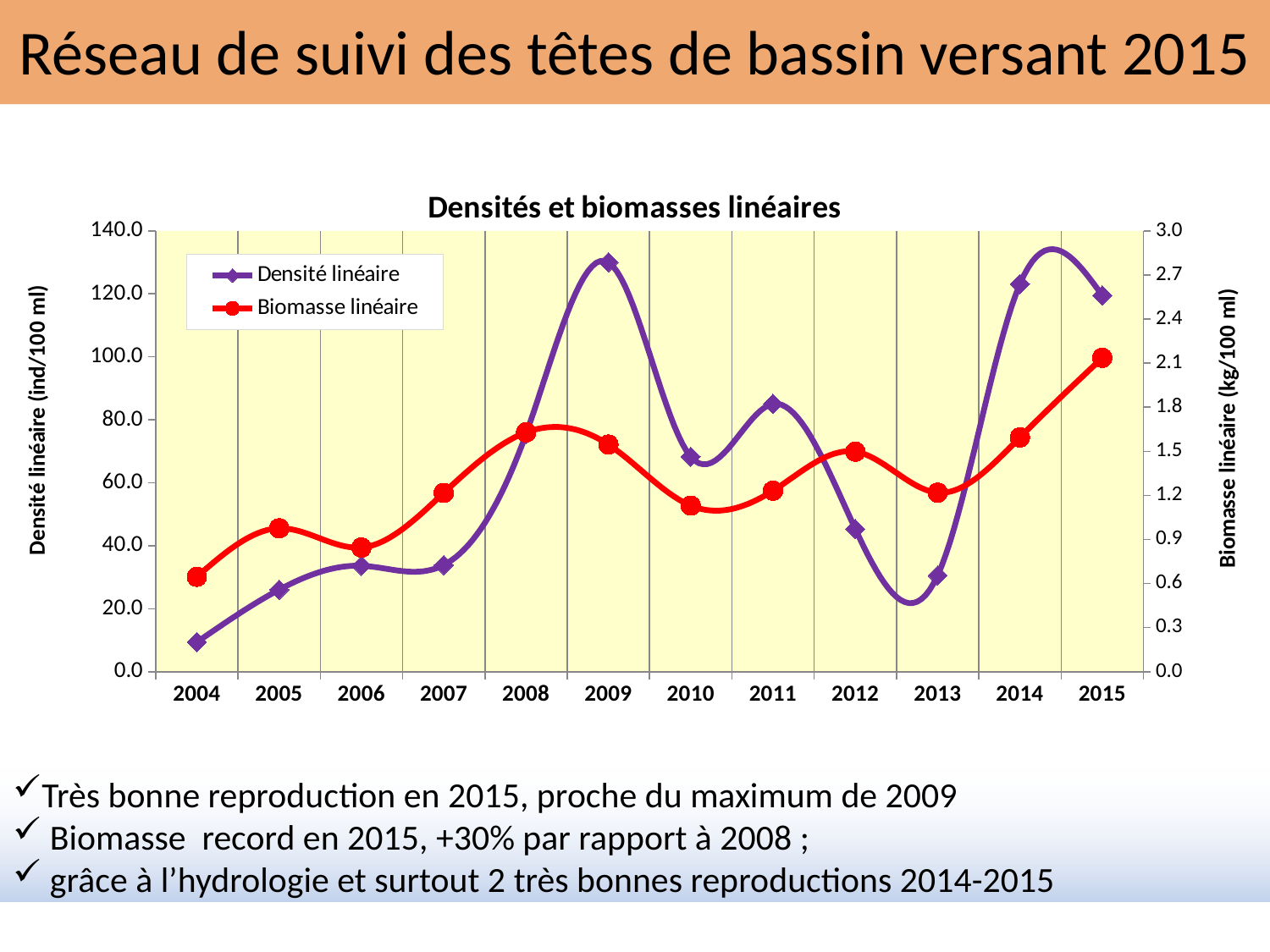
Is the Densité linéaire value for 2009 greater or less than 120? greater Which year has the larger Densité linéaire value, 2009 or 2011? 2009 In which year is Densité linéaire lowest? 2004 How many years are plotted along the x axis? 12 How many series does the legend list? 2 Is the Densité linéaire value for 2013 greater or less than 40? less In which year is Densité linéaire highest? 2009 Is the Biomasse linéaire value for 2015 greater or less than 1.8? greater What type of chart is shown on the slide? line chart In which year is Biomasse linéaire highest? 2015 In which year is Biomasse linéaire lowest? 2004 What is the title of the chart? Densités et biomasses linéaires